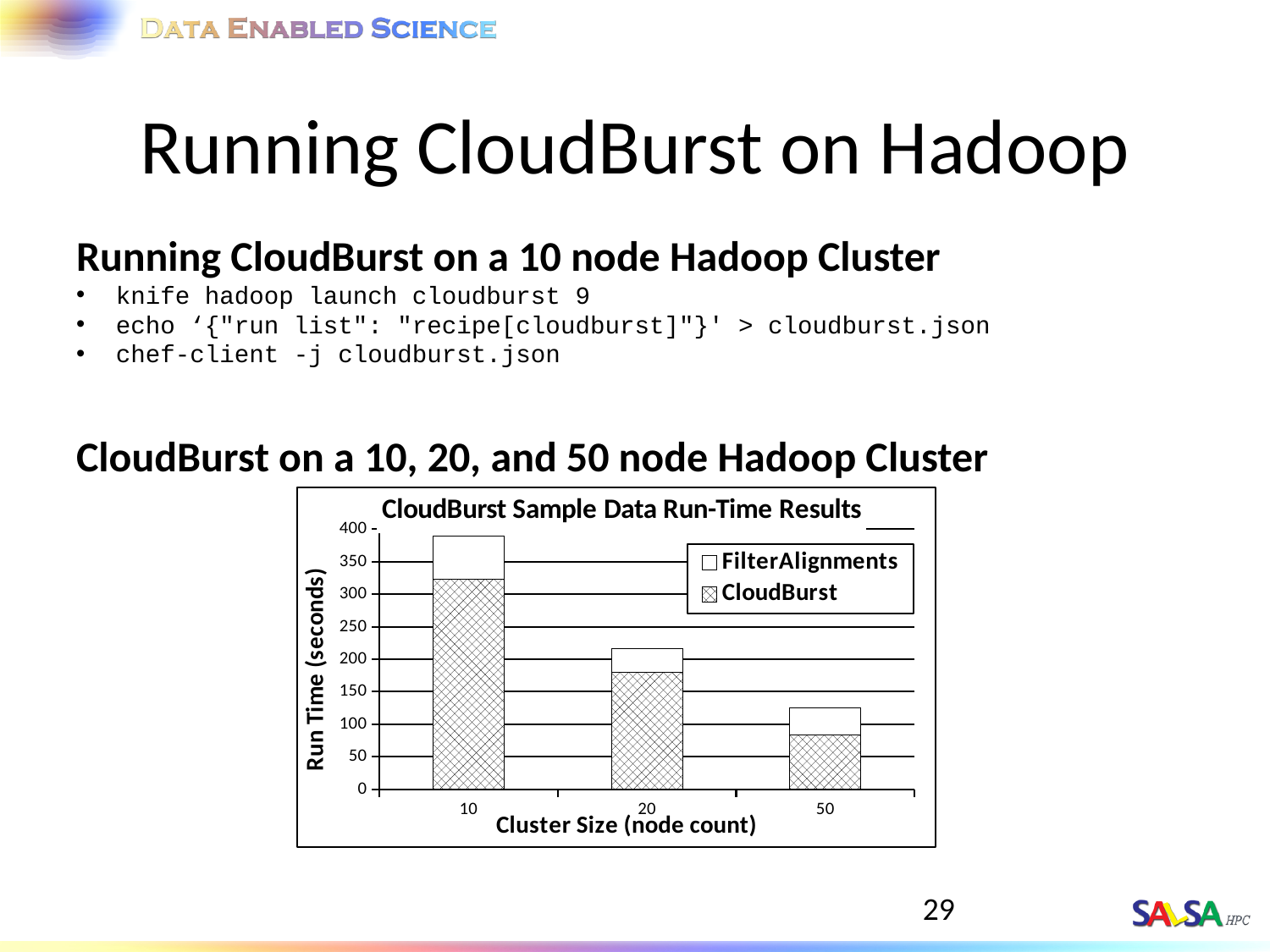
Which cluster size has the highest total run time? 10 How many series does the chart legend list? 2 Which is larger, the CloudBurst run time for the 20 node cluster or for the 50 node cluster? 20 node cluster What is the title of the chart? CloudBurst Sample Data Run-Time Results Is the total run time for the 10 node cluster greater or less than 350 seconds? greater Which cluster size has the lowest total run time? 50 What kind of chart is shown on the slide? stacked bar chart How many cluster sizes are plotted on the x axis? 3 Is the CloudBurst run time for the 20 node cluster greater or less than 200 seconds? less Is the total run time for the 50 node cluster greater or less than 100 seconds? greater What is the label of the y axis? Run Time (seconds) Does the total run time rise or fall as the cluster size increases along the x axis? fall